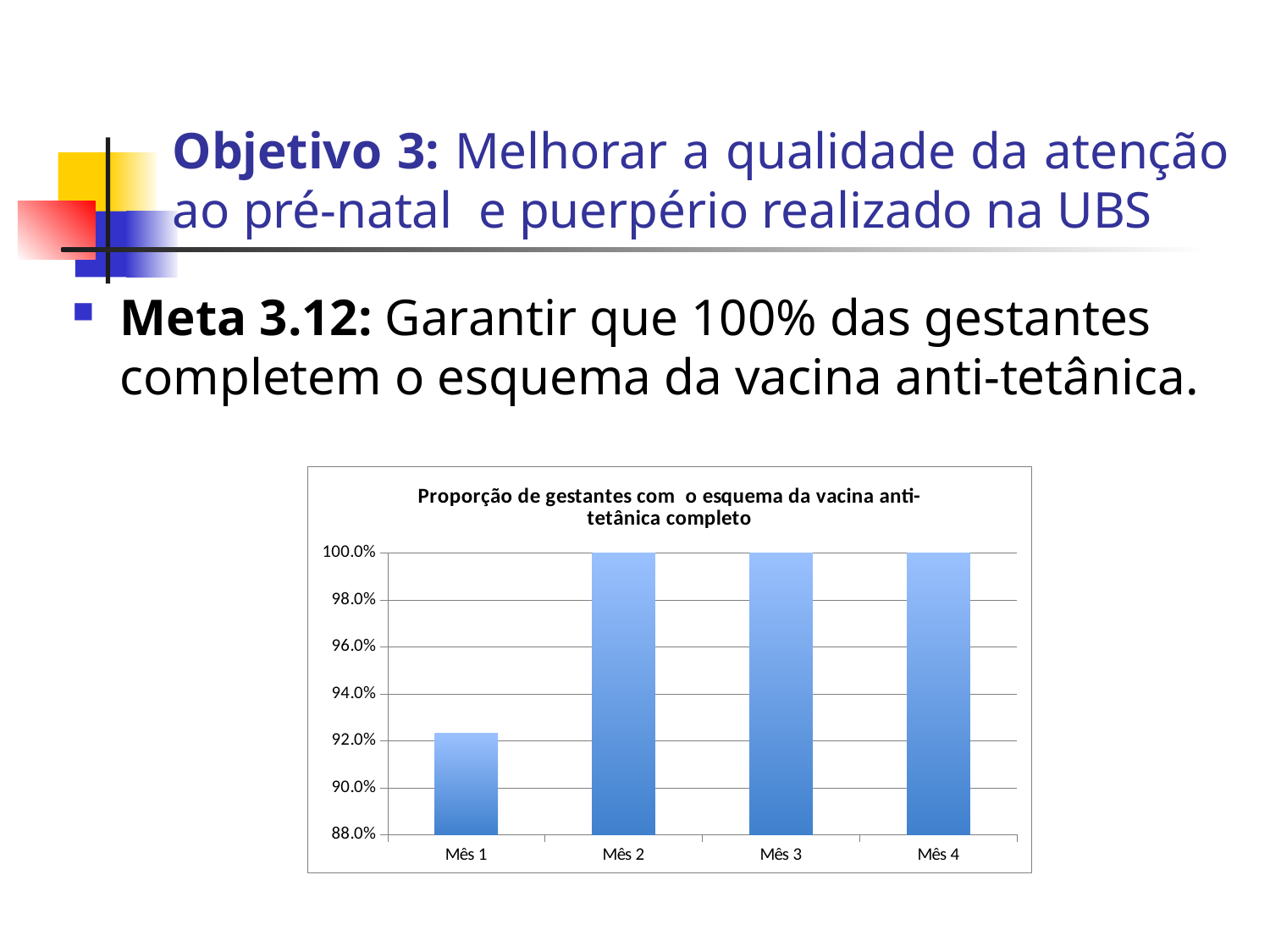
How many months (categories) are shown on the x axis of the chart? 4 Does the value rise or fall from Mês 1 to Mês 2? rise Is the value for Mês 1 greater or less than 90.0%? greater What is the value for Mês 4 in the chart? 100.0% What is the value for Mês 3 in the chart? 100.0% Is the value for Mês 1 greater or less than 94.0%? less What kind of chart is shown on the slide? bar chart Which is larger, the value for Mês 1 or the value for Mês 2? Mês 2 Which month has the lowest value in the chart? Mês 1 What is the title of the chart? Proporção de gestantes com o esquema da vacina anti-tetânica completo What is the lowest value shown on the y axis of the chart? 88.0% What is the value for Mês 2 in the chart? 100.0%